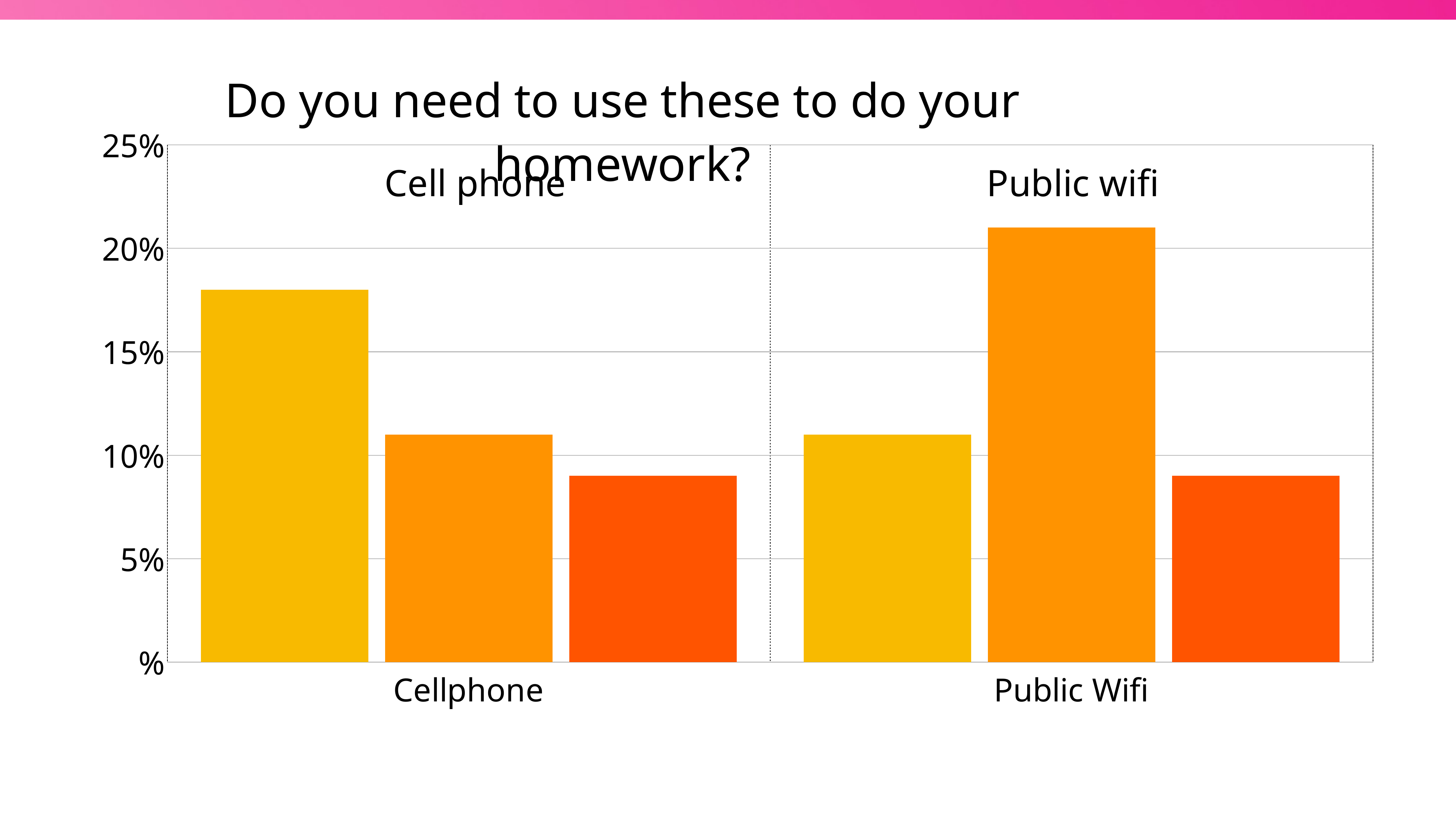
Which category has the larger orange bar, Cellphone or Public Wifi? Public Wifi What is the title of the chart? Do you need to use these to do your homework? How many categories are shown on the x axis of the chart? 2 Is the yellow bar for Public Wifi greater or less than 15%? less How many bars are plotted for each category in the chart? 3 Is the yellow bar for Cellphone greater or less than 15%? greater Which category has the larger yellow bar, Cellphone or Public Wifi? Cellphone Is the orange bar for Public Wifi greater or less than 15%? greater Which category contains the tallest bar in the chart? Public Wifi What kind of chart is shown on the slide? bar chart